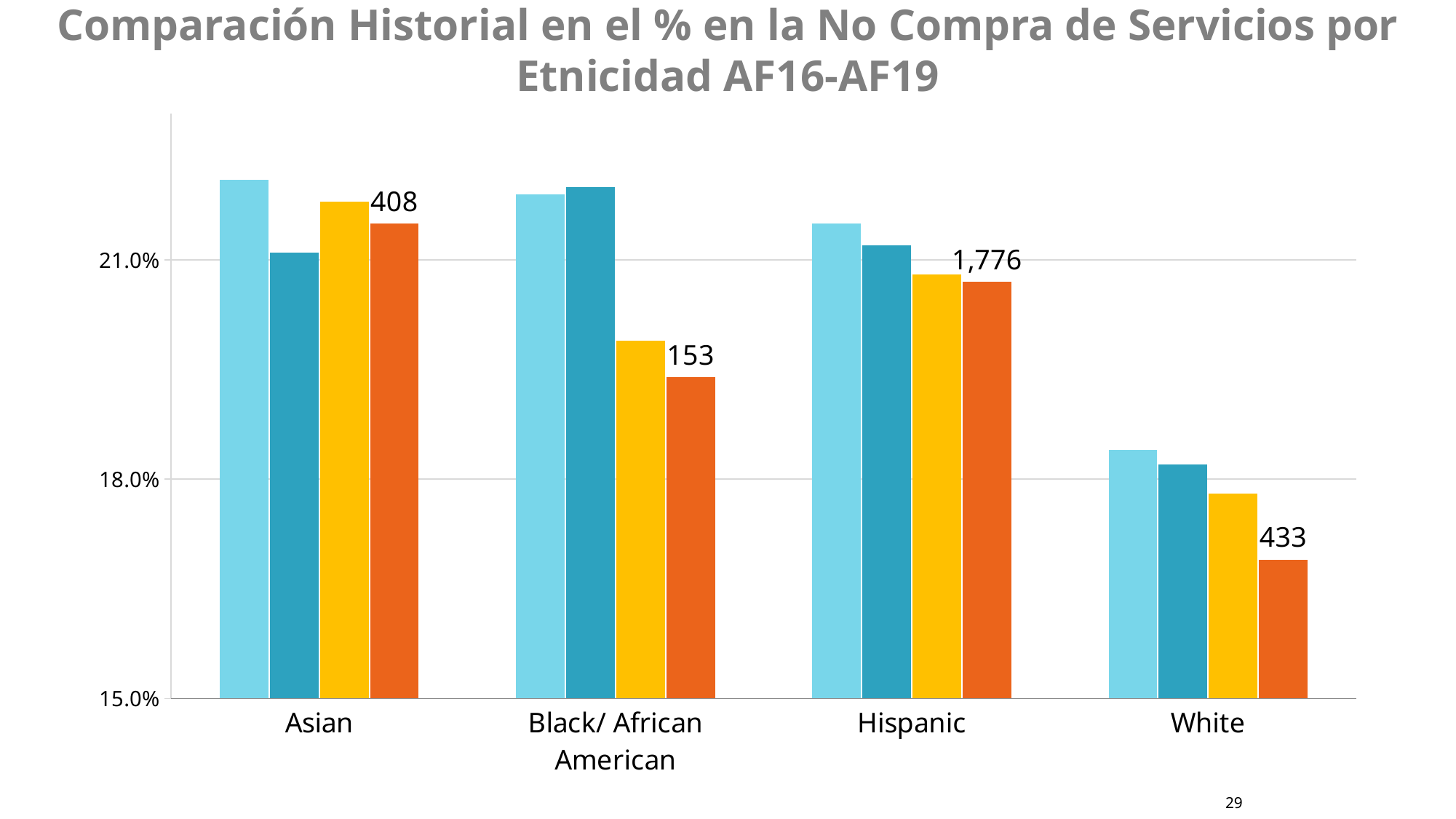
What data label is printed on the orange bar for Black/ African American? 153 Is the value of the light blue bar for Asian greater or less than 21.0%? greater Which category has the highest orange bar? Asian Which category has the lowest orange bar? White What data label is printed on the orange bar for Hispanic? 1,776 What data label is printed on the orange bar for White? 433 Is the value of the orange bar for White greater or less than 18.0%? less What kind of chart is shown on the slide? bar chart Which is larger, the orange bar for Hispanic or the orange bar for Black/ African American? Hispanic How many ethnicity categories are shown on the x axis? 4 How many bars are plotted for each ethnicity category? 4 What data label is printed on the orange bar for Asian? 408